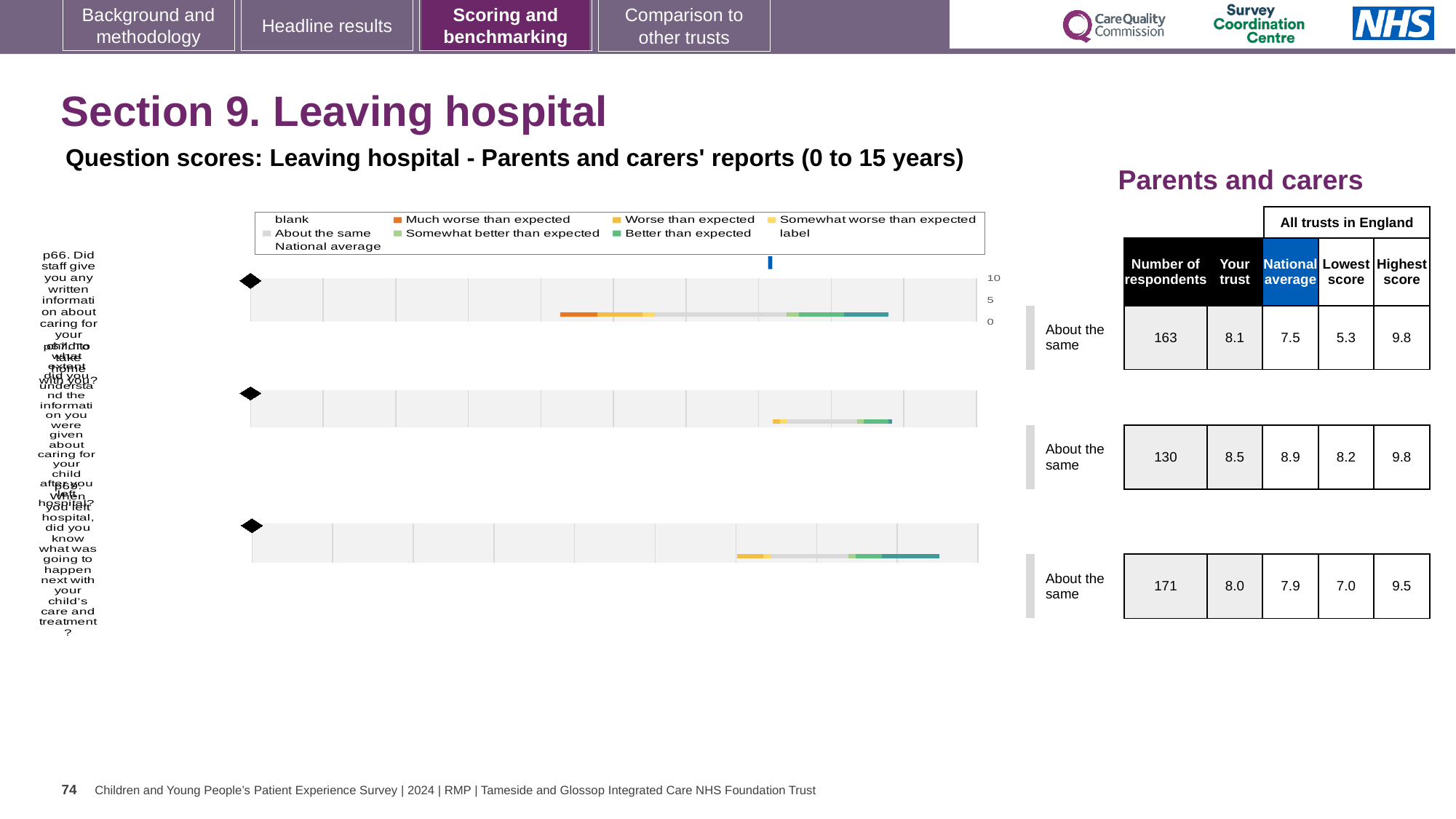
For the middle chart (p67), what is the difference between the national average (8.9) and the trust score (8.5)? 0.4 For the top chart (p66, written information about caring for your child), what is the 'Your trust' score shown in the table? 8.1 What benchmark category is shown beside each of the three charts? About the same Which of the three charts has the highest 'Your trust' score? the middle chart (p67), 8.5 How many benchmark bar charts are shown on the slide? 3 For the bottom chart (p68, did you know what was going to happen next), what is the number of respondents? 171 For the middle chart (p67), what is the 'Your trust' score? 8.5 Which of the three charts has the lowest 'Lowest score' across all trusts in England? the top chart (p66), 5.3 In the chart legend, which colour represents 'Much worse than expected'? orange For the top chart (p66), what is the national average score? 7.5 For the bottom chart (p68), is the trust score higher or lower than the national average? higher What kind of chart is used for the top chart on the slide (p66)? bar chart